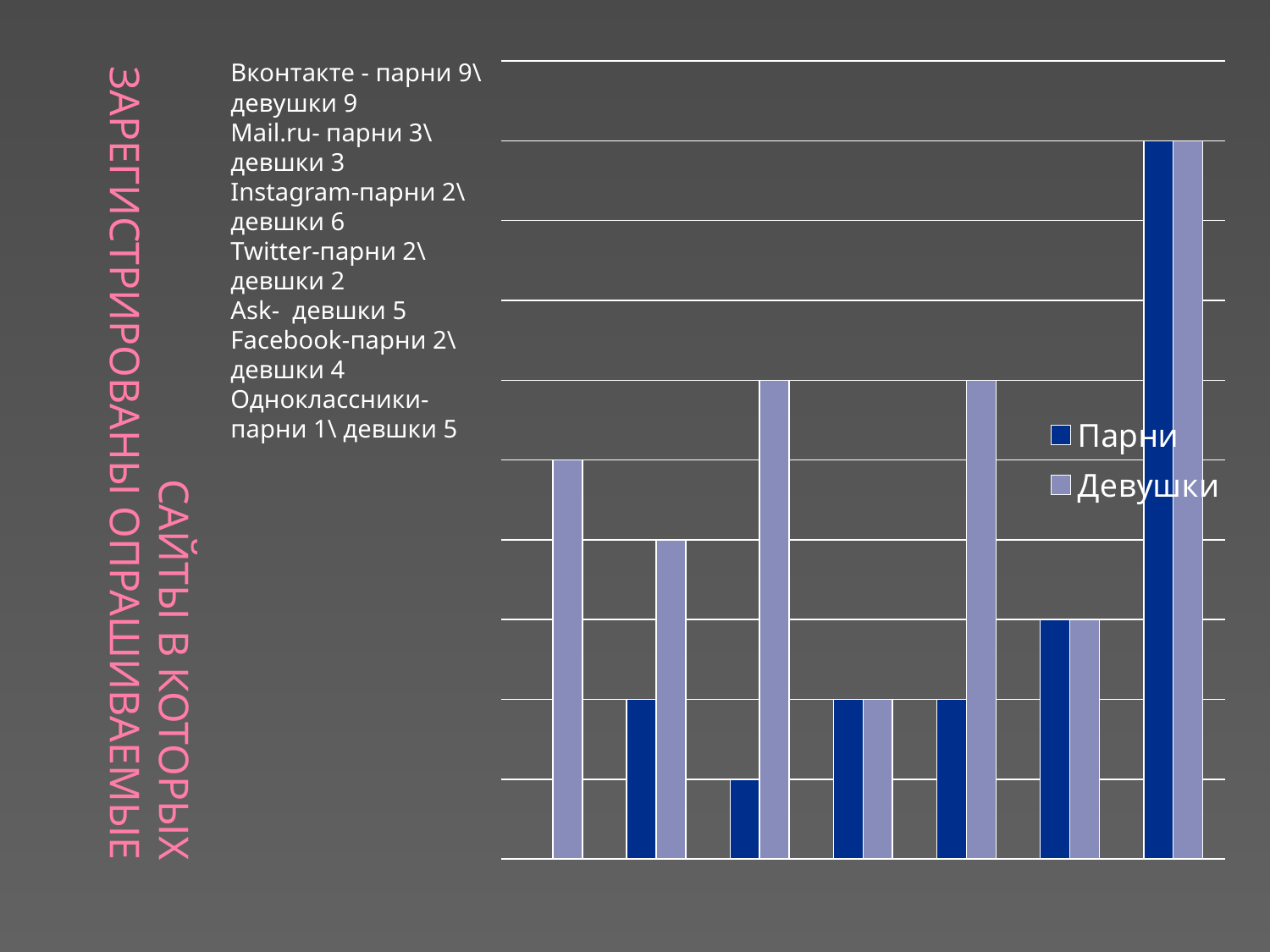
What are the two series named in the chart legend? Парни and Девушки In the second group of bars from the left, which series has the taller bar? Девушки How many groups of bars are plotted along the x axis? 7 In the third group of bars from the left, which series has the taller bar? Девушки Which bar is the shortest on the chart? the Парни bar in the third group from the left In the fifth group of bars from the left, which series has the taller bar? Девушки How many series does the chart legend list? 2 How many groups on the chart contain only a single bar? 1 What colour represents the Парни series in the chart? dark blue What kind of chart is shown on the slide? bar chart Which group of bars reaches the highest value on the chart? the rightmost (seventh) group